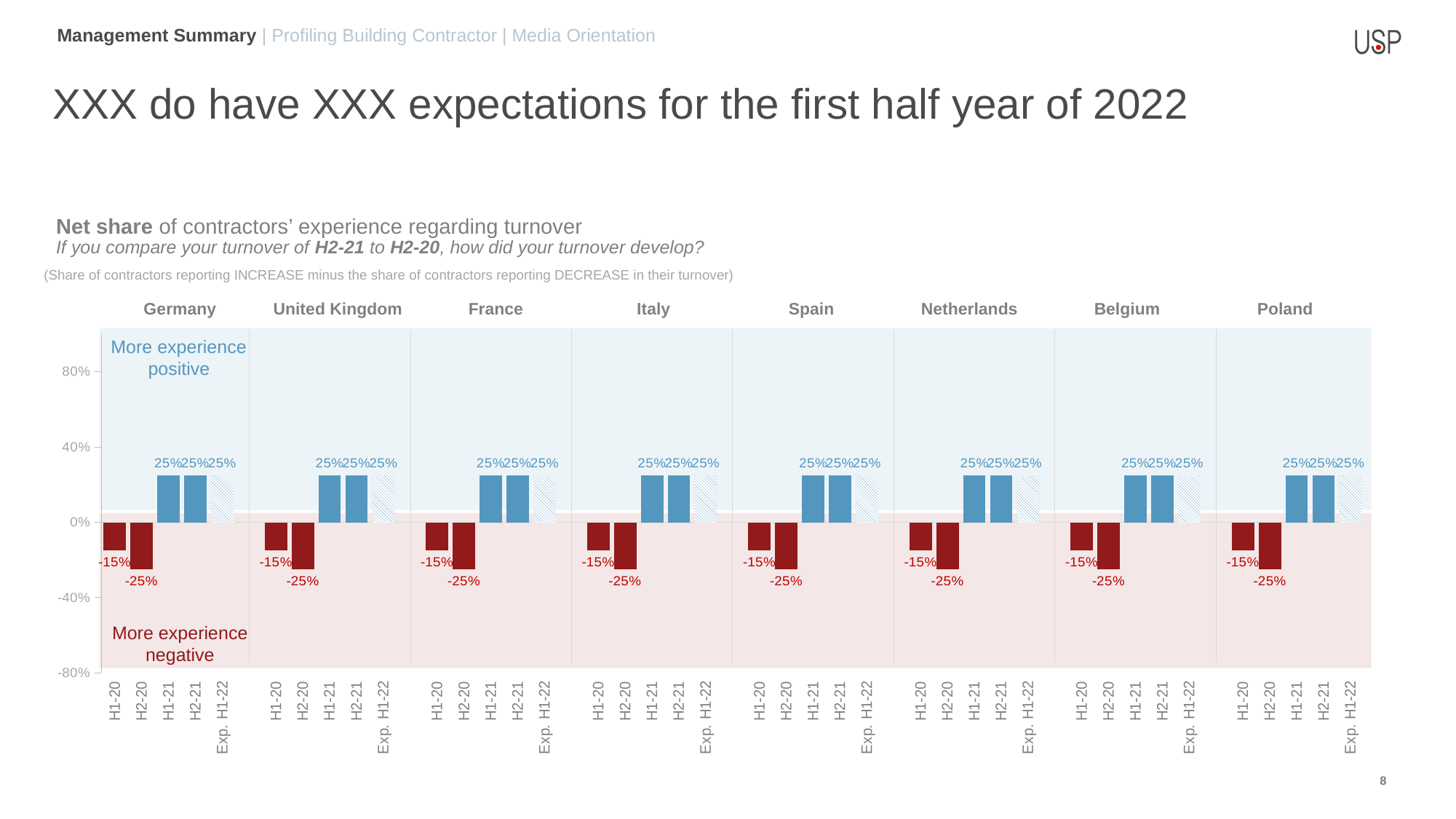
Which period has the lowest net share value in the Italy panel? H2-20 What kind of chart is shown on the slide? Bar chart What is the net share value for H1-20 in Poland? -15% What is the difference in percentage points between the H1-21 and H2-20 values for the United Kingdom? 50 percentage points What is the net share value for H1-21 in France? 25% What is the difference in percentage points between the H1-20 and H2-20 values for Belgium? 10 percentage points What is the expected net share value for Exp. H1-22 in Spain? 25% What is the net share value for H2-20 in Germany? -25% Is the value for H1-21 in Germany greater or less than 40%? less How many periods are plotted for each country? 5 How many countries are shown in the chart? 8 In the Netherlands panel, which is larger: the value for H1-20 or the value for H2-20? H1-20